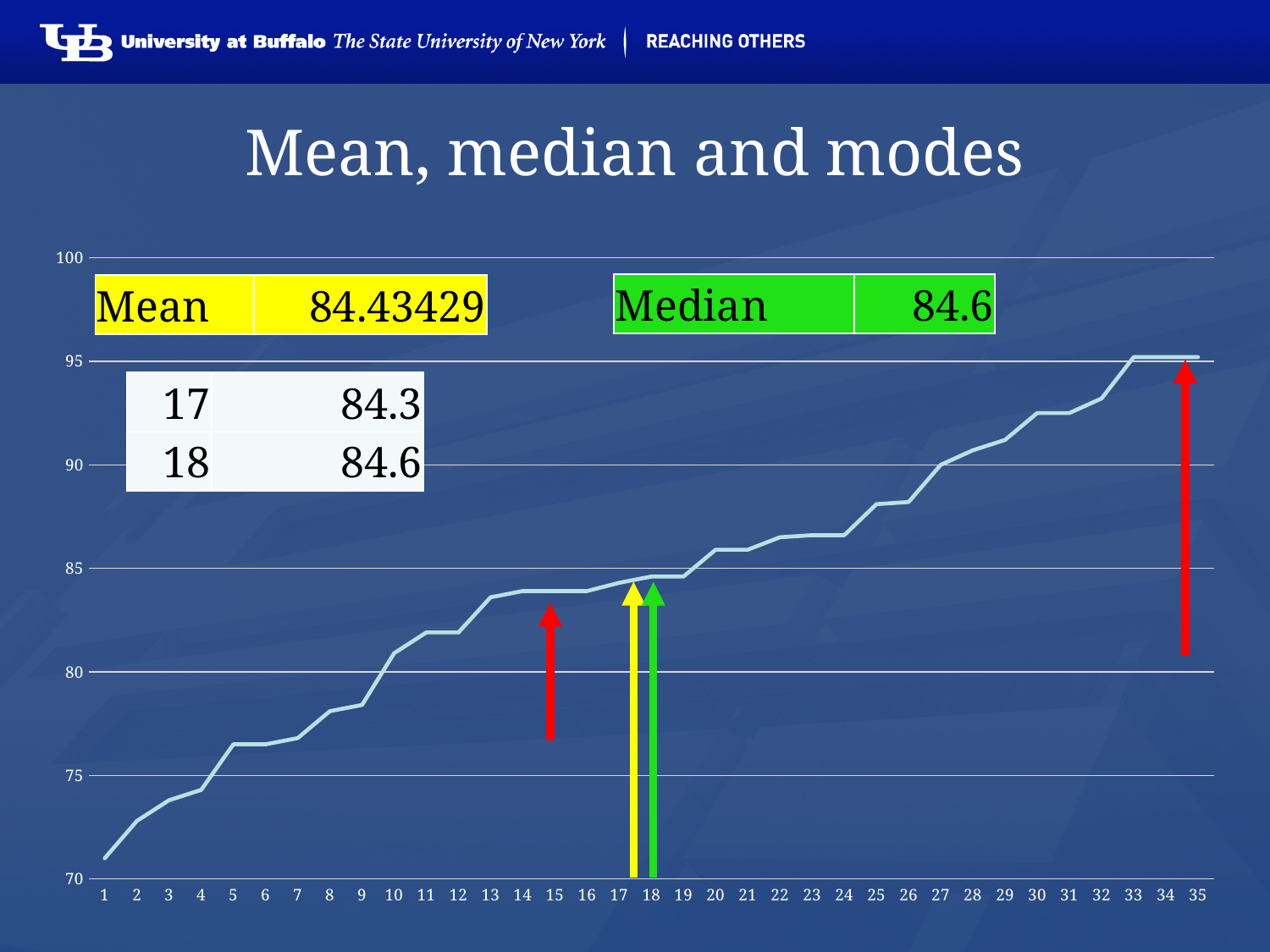
What is the difference between the values at points 18 and 17? 0.3 Do the plotted values rise or fall as the x axis goes from 1 to 35? rise What median value is shown in the green box on the chart? 84.6 Is the value at point 1 greater or less than 75? less What is the value at point 17, as shown in the table on the chart? 84.3 What is the value at point 18, as shown in the table on the chart? 84.6 What kind of chart is shown on the slide? line chart What mean value is shown in the yellow box on the chart? 84.43429 Is the value at point 30 greater or less than 90? greater How many points are plotted along the x axis of the chart? 35 Which has the larger value, point 17 or point 18? 18 Which point on the x axis has the lowest value? 1